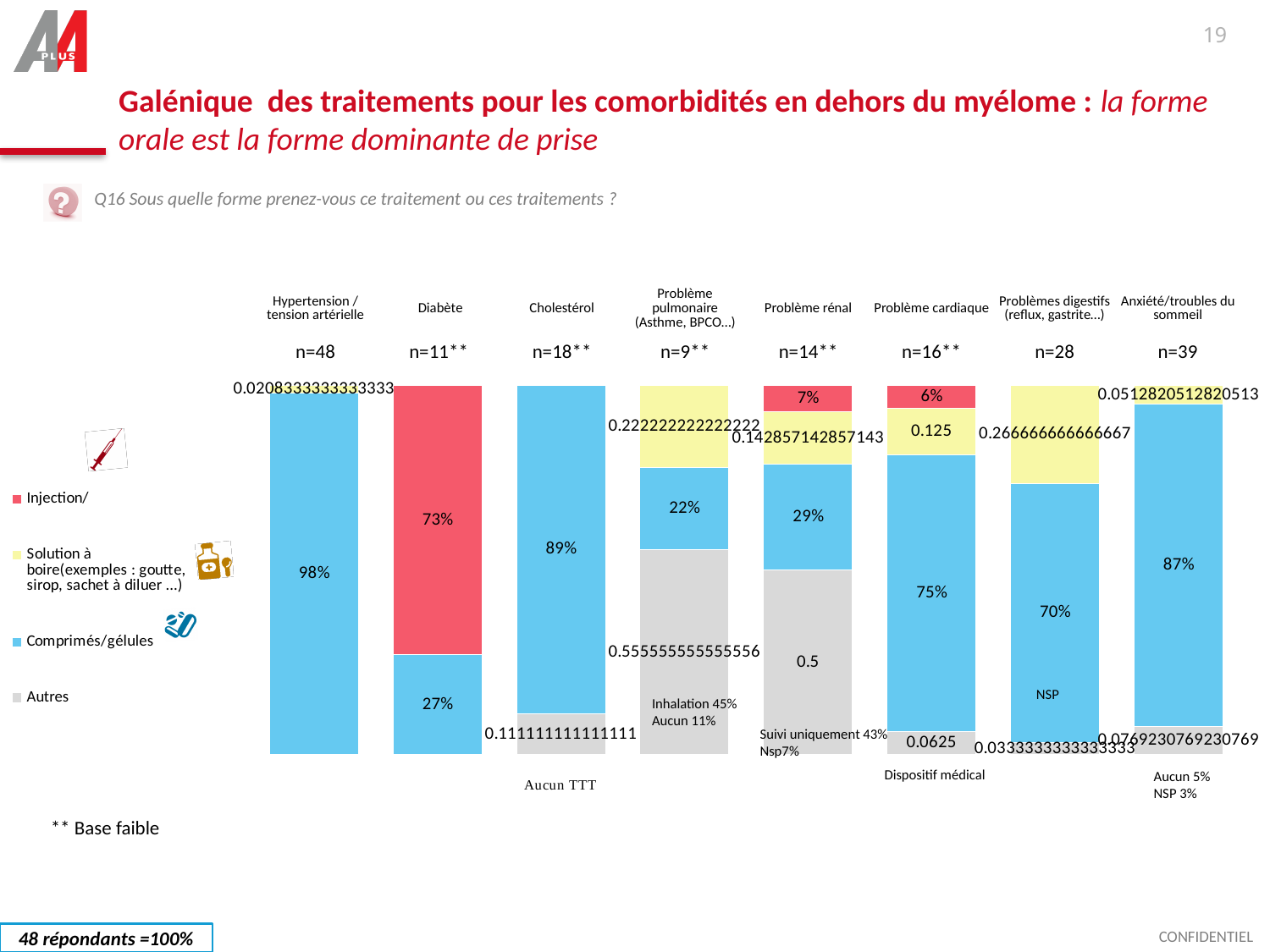
What is the value for Comprimés/gélules for Problème cardiaque? 75% Which category has the lowest value for Comprimés/gélules? Problème pulmonaire (Asthme, BPCO…) How many series does the legend list? 4 What is the value for Comprimés/gélules for Cholestérol? 89% Which category has the highest value for Comprimés/gélules? Hypertension / tension artérielle How many categories (comorbidities) are shown in the chart? 8 Which is larger for Problème rénal: the Comprimés/gélules value or the Injection/ value? Comprimés/gélules What kind of chart is shown on the slide? Stacked bar chart What is the value for Comprimés/gélules for Hypertension / tension artérielle? 98% What is the value for Injection/ for Diabète? 73% For Diabète, what is the difference between the Injection/ value and the Comprimés/gélules value? 46% What is the value for Comprimés/gélules for Anxiété/troubles du sommeil? 87%